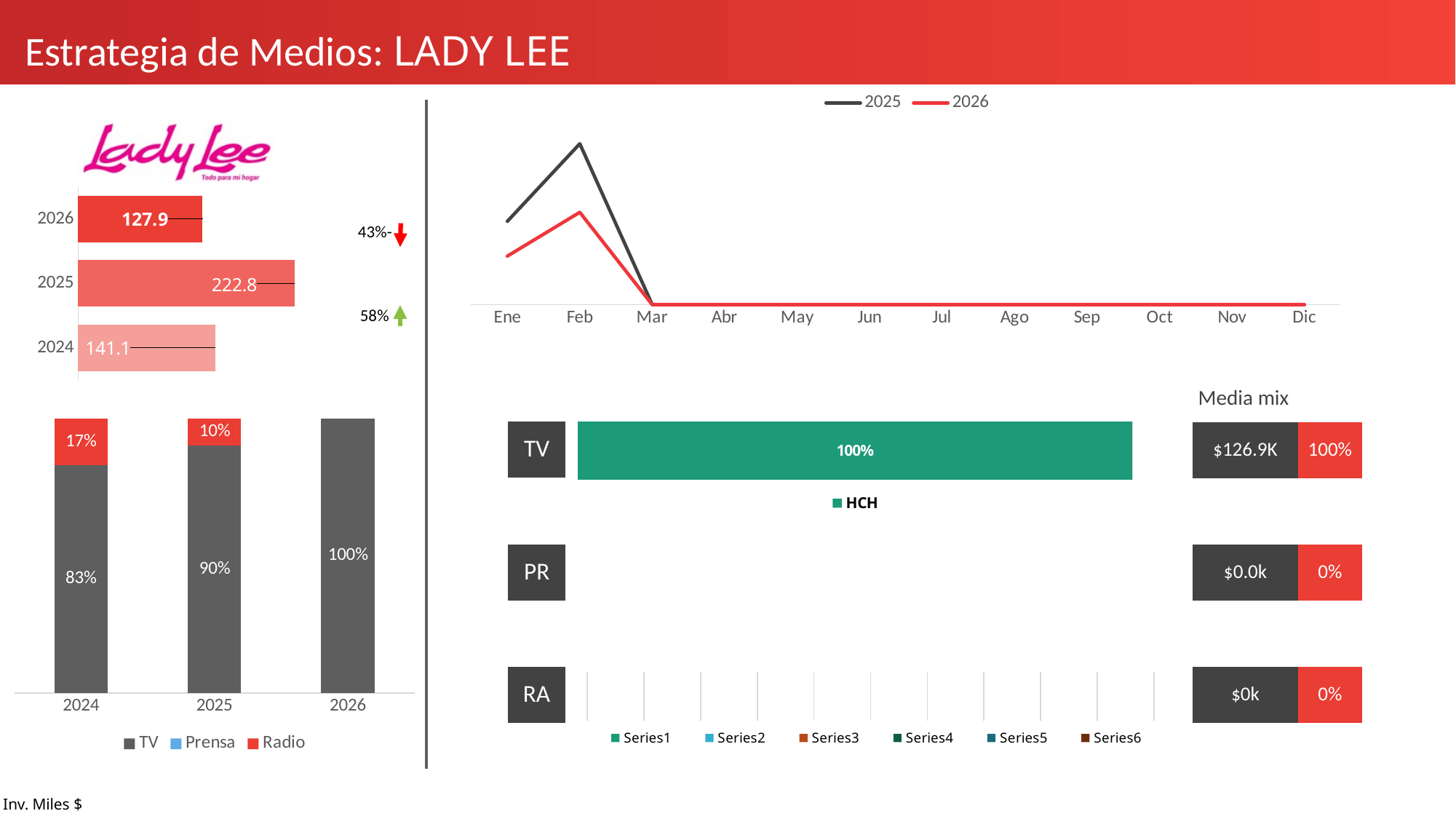
In the top-left horizontal bar chart, which year has the lowest value? 2026 In the Media mix table, what is the amount shown for TV? $126.9K In the top-left horizontal bar chart, what is the difference between the 2025 and 2024 values? 81.7 In the top-left horizontal bar chart, what is the value for 2026? 127.9 How many series does the legend of the bottom-left stacked bar chart list? 3 In the top-left horizontal bar chart, what is the value for 2025? 222.8 In the bottom-left stacked bar chart, what is the Radio share for 2025? 10% What kind of chart is the top-right chart showing 2025 and 2026 by month? Line chart In the top-right line chart, in which month do both series reach their peak? Feb In the top-right line chart, which series has the higher value in Feb, 2025 or 2026? 2025 In the bottom-left stacked bar chart, what is the TV share for 2024? 83% In the top-left horizontal bar chart, which year has the highest value? 2025